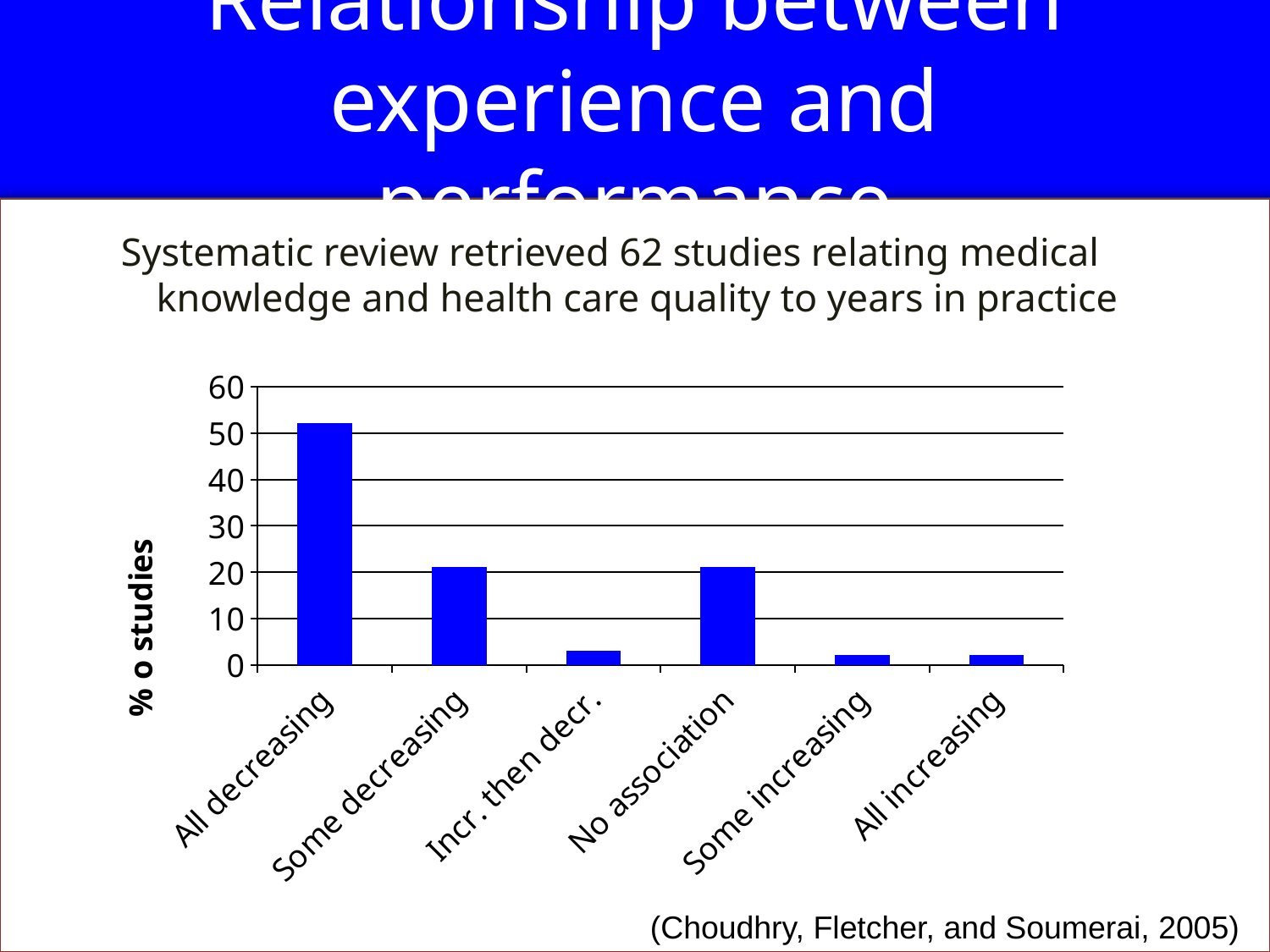
Is the value for Some increasing greater or less than 10? less Which is larger, the value for No association or the value for All increasing? No association Is the value for Some decreasing greater or less than 10? greater Is the value for Incr. then decr. greater or less than 10? less How many categories are shown on the x axis of the chart? 6 Which category has the highest value in the chart? All decreasing Which is larger, the value for All decreasing or the value for Some decreasing? All decreasing What is the label on the y axis of the chart? % o studies What kind of chart is shown on the slide? bar chart